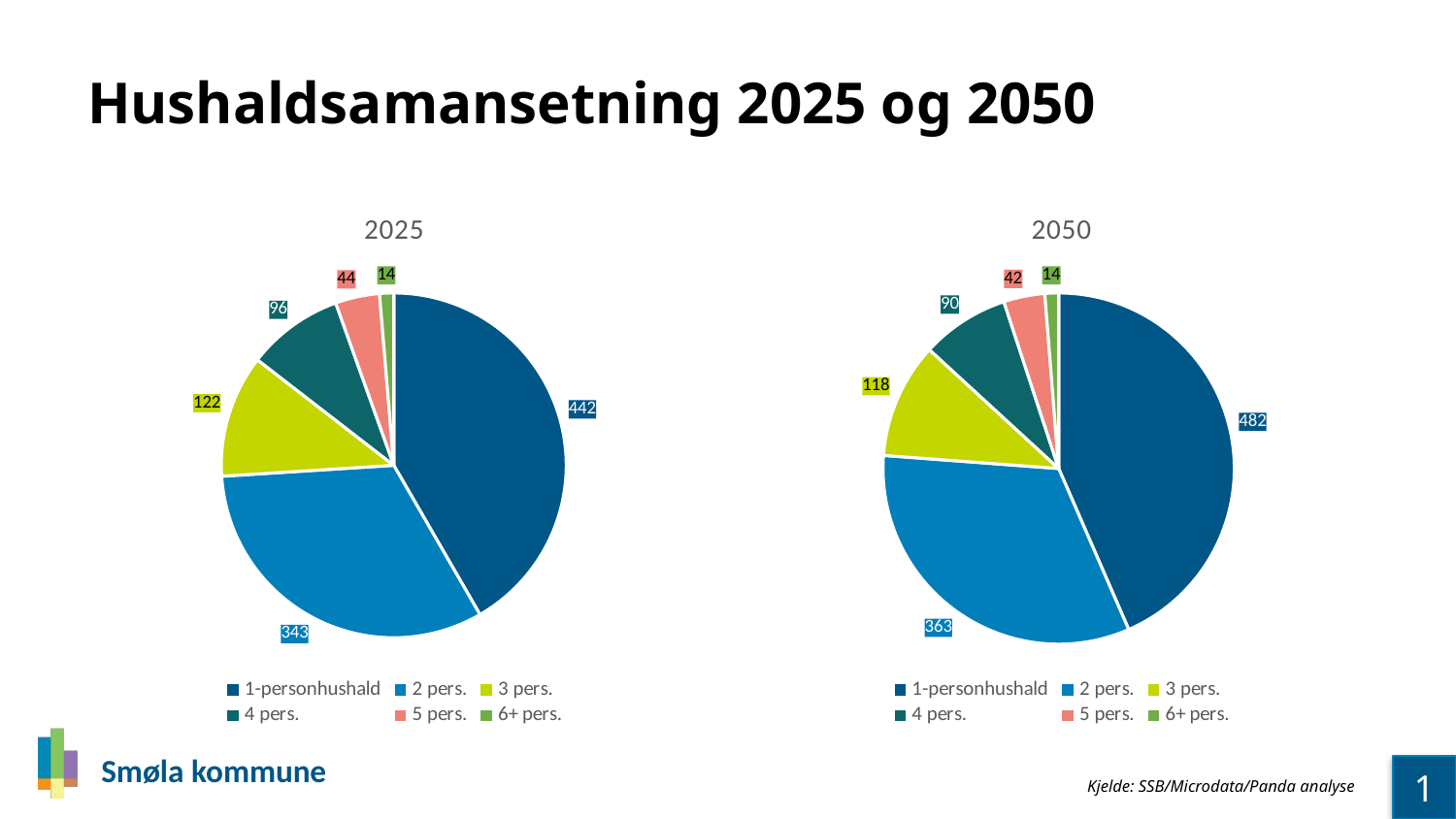
Which is larger: the 5 pers. value in the 2025 chart or in the 2050 chart? 2025 How many categories does the 2050 chart show? 6 In the 2050 chart, which category has the largest slice? 1-personhushald What type of chart is the 2025 chart? pie chart What is the title of the slide? Hushaldsamansetning 2025 og 2050 In the 2050 chart, what is the value for 2 pers.? 363 What is the difference between the 1-personhushald value in the 2050 chart and in the 2025 chart? 40 In the 2025 chart, what is the difference between the 2 pers. and 3 pers. values? 221 In the 2025 chart, what is the value for 3 pers.? 122 In the 2025 chart, which category has the smallest slice? 6+ pers. In the 2025 chart, what is the value for 1-personhushald? 442 In the 2050 chart, what is the value for 4 pers.? 90